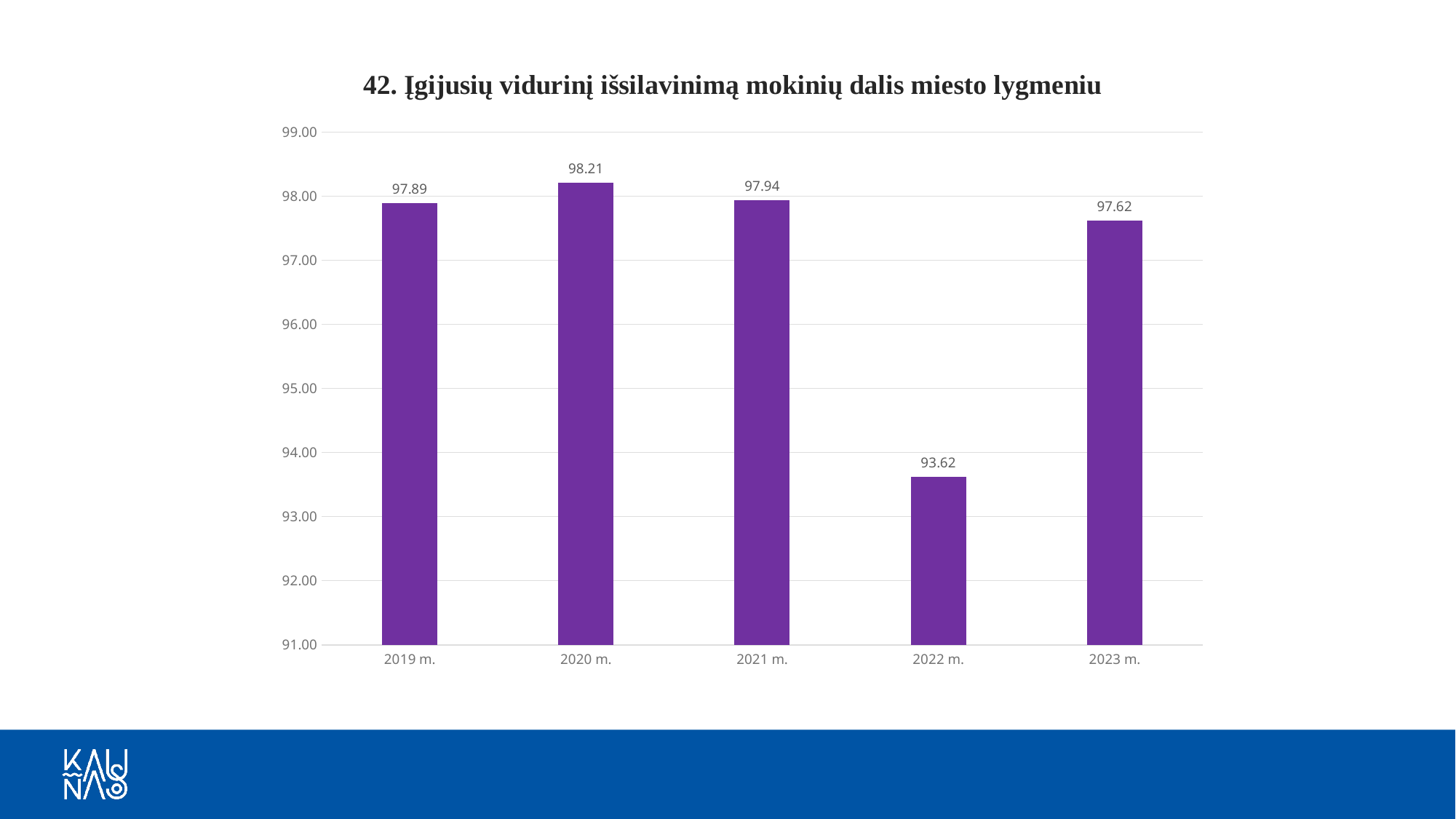
What kind of chart is shown on the slide? bar chart Which year has the highest value? 2020 m. What is the value for 2019 m.? 97.89 Is the value for 2022 m. greater or less than 94.00? less Which is larger, the value for 2019 m. or the value for 2023 m.? 2019 m. What is the difference between the values for 2021 m. and 2023 m.? 0.32 What is the value for 2023 m.? 97.62 Which year has the lowest value? 2022 m. What is the value for 2022 m.? 93.62 What is the difference between the values for 2020 m. and 2022 m.? 4.59 How many years are shown on the chart? 5 What is the title of the chart? 42. Įgijusių vidurinį išsilavinimą mokinių dalis miesto lygmeniu